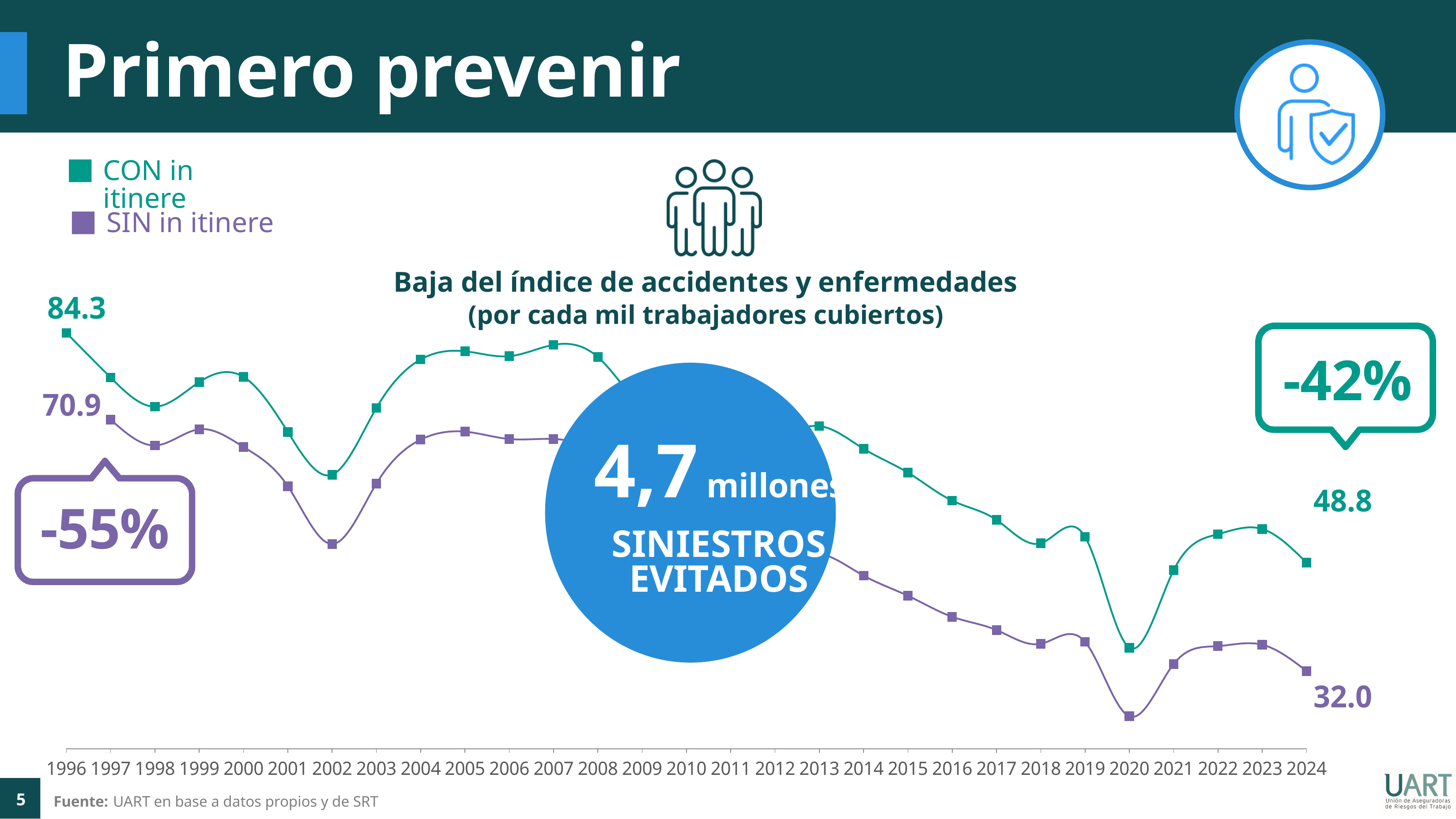
Overall, do the values of the CON in itinere series rise or fall from 1996 to 2024? fall What is the value of the CON in itinere series in 2024? 48.8 In 2024, which series has the larger value, CON in itinere or SIN in itinere? CON in itinere In which year does the SIN in itinere series reach its lowest value? 2020 What type of chart is shown on the slide? line chart How many series does the legend list? 2 What is the value of the SIN in itinere series in 2024? 32.0 What is the value of the CON in itinere series in 1996? 84.3 How many years are shown on the x axis? 29 What is the difference between the CON in itinere values in 1996 and 2024? 35.5